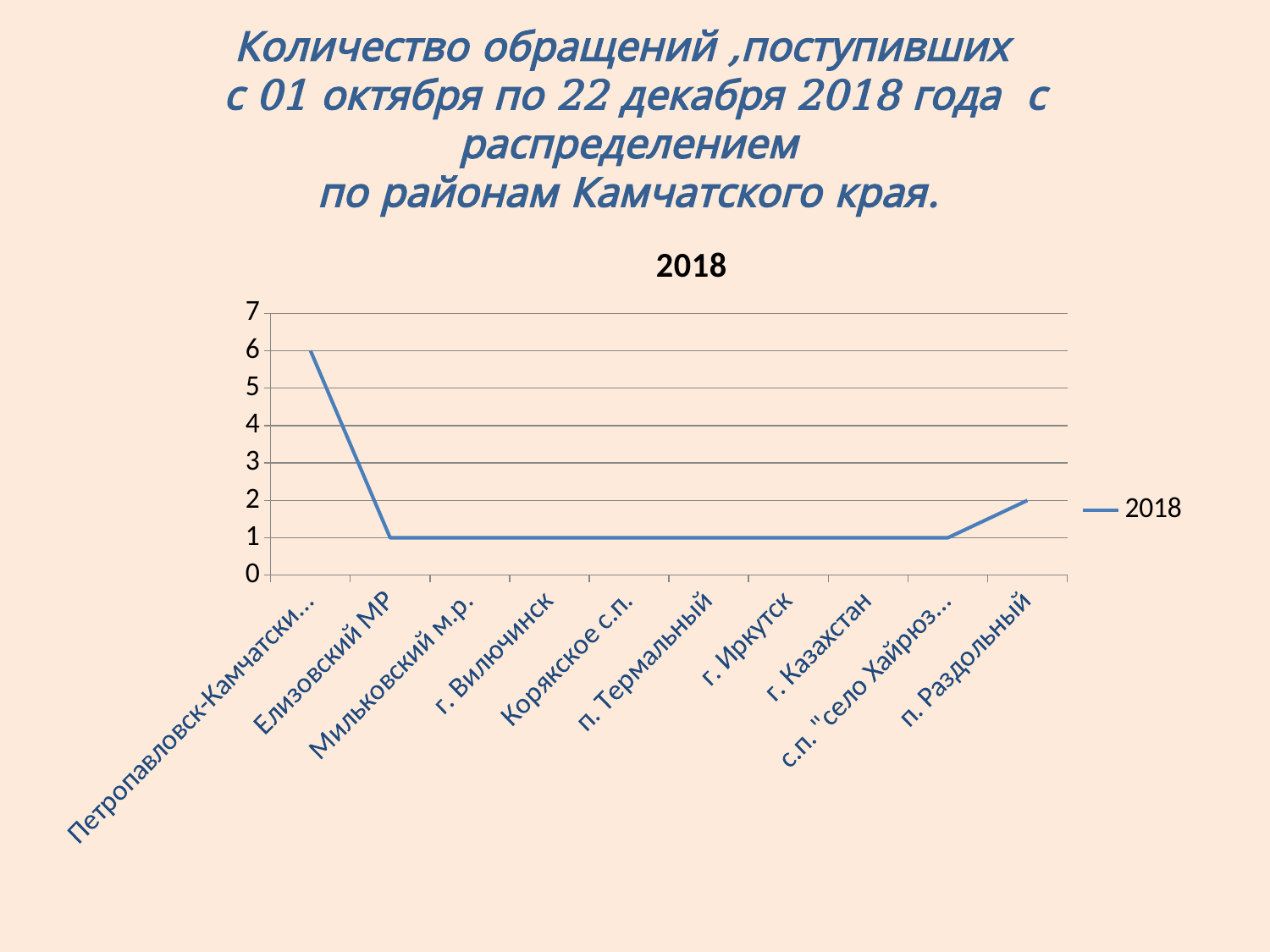
What is the title of the chart? 2018 How many categories are plotted along the x axis? 10 What is the value for the first category, Петропавловск-Камчатски...? 6 Is the value for the first category (Петропавловск-Камчатски...) greater or less than 4? greater What is the value for г. Вилючинск? 1 Which is larger, the value for п. Раздольный or the value for г. Иркутск? п. Раздольный What kind of chart is shown on the slide? line chart What is the value for п. Раздольный? 2 What is the value for Елизовский МР? 1 What is the difference between the value for the first category (Петропавловск-Камчатски...) and the value for п. Раздольный? 4 Which category has the highest value? Петропавловск-Камчатски... (the first category) How many series does the legend list? 1